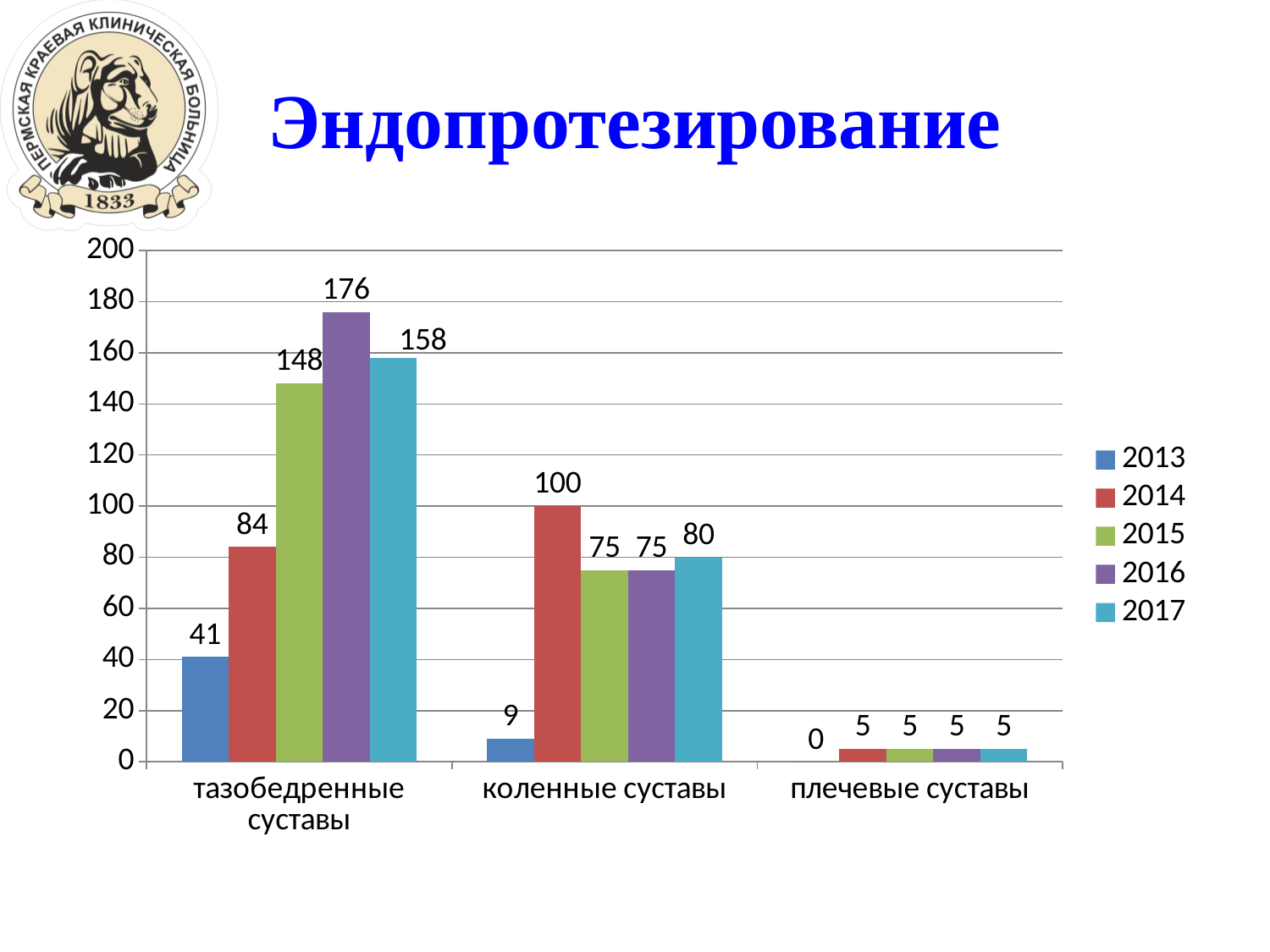
Which is larger for коленные суставы: the 2014 value or the 2017 value? 2014 What is the value for 2013 in the коленные суставы category? 9 What is the value for 2016 in the тазобедренные суставы category? 176 How many categories are shown on the x axis? 3 How many series does the legend list? 5 What kind of chart is shown on the slide? bar chart Which year has the highest value for тазобедренные суставы? 2016 What is the title of the slide? Эндопротезирование Which year has the lowest value for коленные суставы? 2013 What is the value for 2014 in the плечевые суставы category? 5 What is the difference between the 2016 and 2017 values for тазобедренные суставы? 18 Is the value for 2015 in тазобедренные суставы greater or less than 140? greater